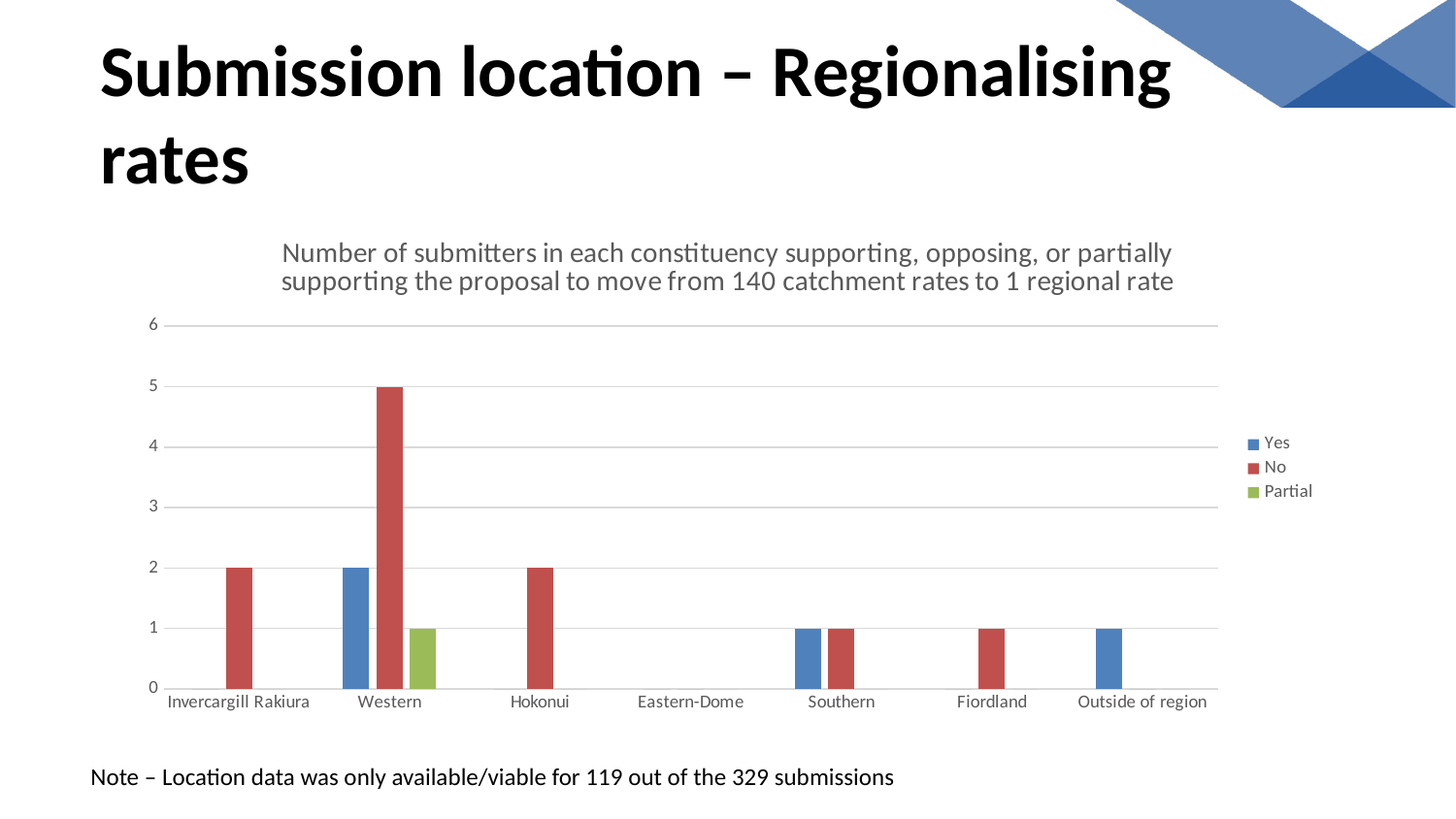
What is the value of the No series for Western? 5 Which constituency has the highest No value? Western How many series does the legend list? 3 How many constituencies are shown on the x axis? 7 Which series is shown in green in the legend? Partial What kind of chart is shown on the slide? bar chart What is the difference between the No value and the Yes value for Western? 3 What is the value of the No series for Invercargill Rakiura? 2 What is the value of the Yes series for Western? 2 Is the No value for Western greater or less than 4? greater Which is larger for Hokonui, the No value or the Yes value? No What is the value of the Partial series for Western? 1